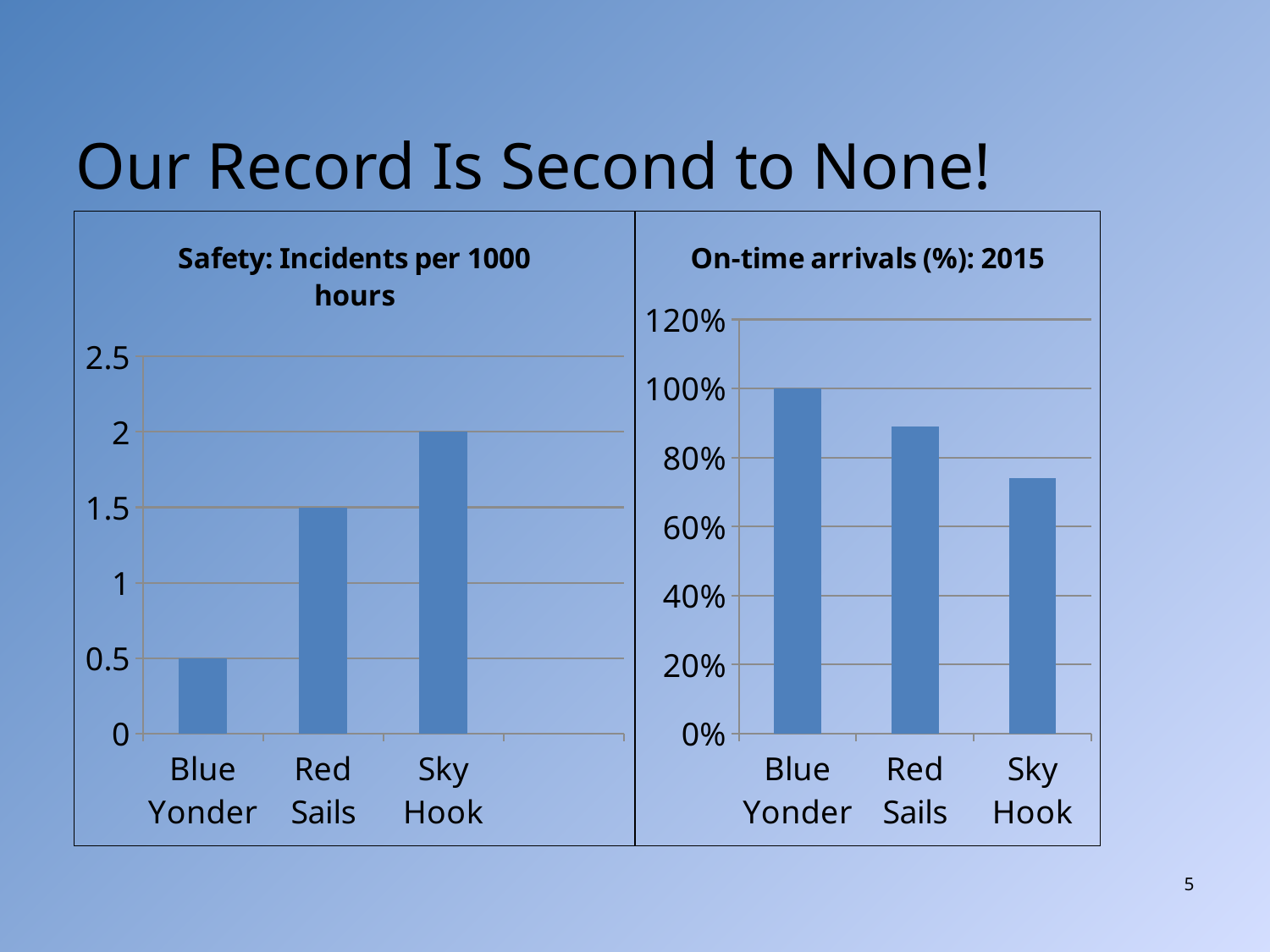
In the Safety: Incidents per 1000 hours chart, what is the value for Sky Hook? 2 In the On-time arrivals (%): 2015 chart, which category has the lowest value? Sky Hook In the Safety: Incidents per 1000 hours chart, which category has the lowest value? Blue Yonder In the Safety: Incidents per 1000 hours chart, which category has the highest value? Sky Hook In the On-time arrivals (%): 2015 chart, do the values rise or fall from Blue Yonder to Sky Hook? fall In the On-time arrivals (%): 2015 chart, what is the value for Blue Yonder? 100% In the On-time arrivals (%): 2015 chart, is the value for Red Sails greater or less than 80%? greater In the Safety: Incidents per 1000 hours chart, what is the difference between Sky Hook and Blue Yonder? 1.5 How many categories are shown in the Safety: Incidents per 1000 hours chart? 3 In the Safety: Incidents per 1000 hours chart, what is the value for Red Sails? 1.5 In the Safety: Incidents per 1000 hours chart, what is the value for Blue Yonder? 0.5 In the On-time arrivals (%): 2015 chart, is the value for Sky Hook greater or less than 80%? less